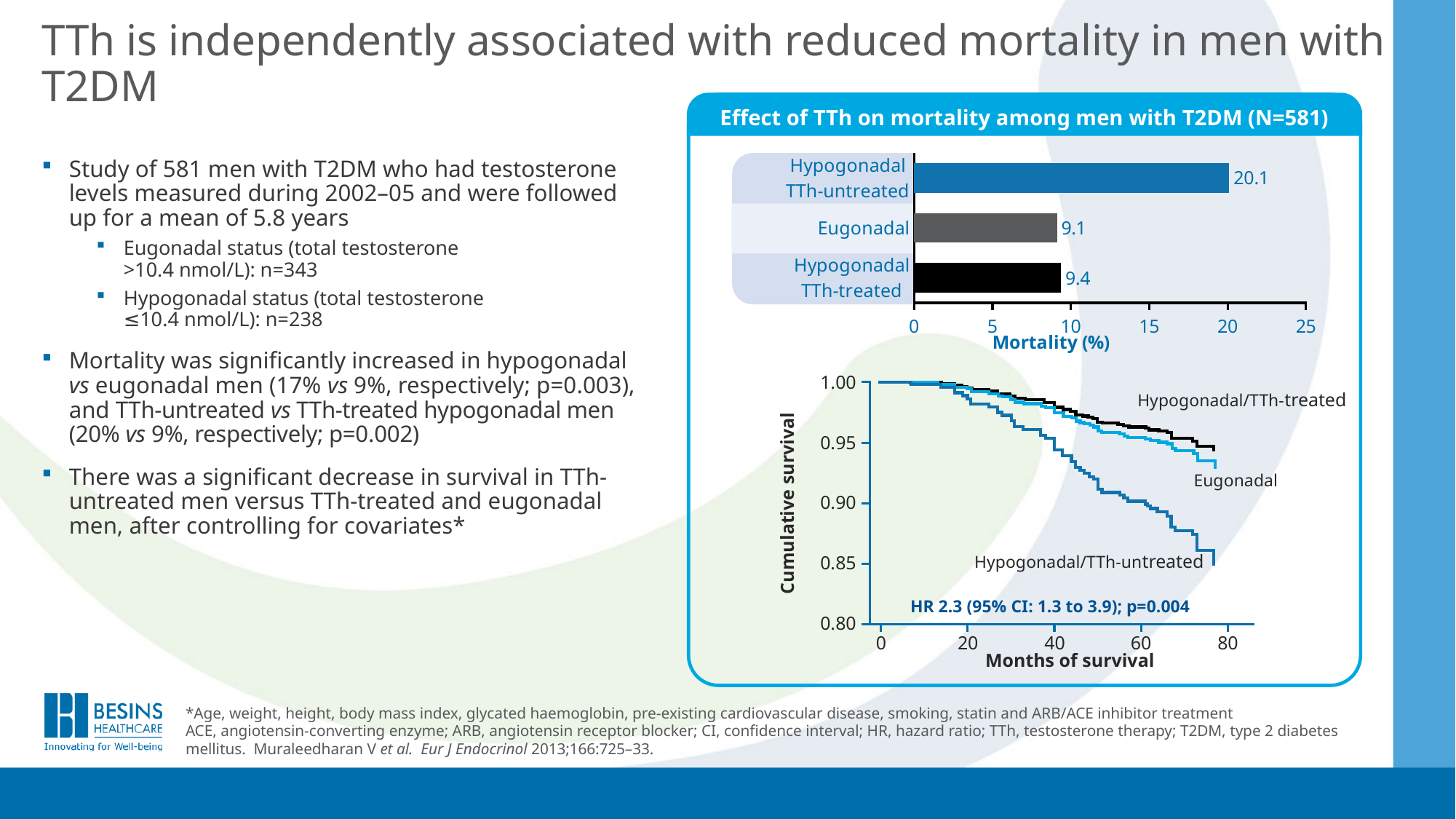
In the bar chart, which group has the lowest mortality? Eugonadal In the survival chart, does cumulative survival rise or fall as months of survival increase? Fall In the bar chart, what is the difference in mortality (%) between Hypogonadal TTh-untreated and Hypogonadal TTh-treated men? 10.7 In the bar chart, is the mortality for Hypogonadal TTh-untreated men greater or less than 15%? greater In the bar chart, which group has the highest mortality? Hypogonadal TTh-untreated What type of chart is the upper chart showing mortality (%)? Bar chart In the bar chart, what is the mortality (%) for Eugonadal men? 9.1 In the survival chart, how many groups (curves) are plotted? 3 In the bar chart, how many groups are shown? 3 In the bar chart, what is the mortality (%) for Hypogonadal TTh-untreated men? 20.1 In the bar chart, what is the mortality (%) for Hypogonadal TTh-treated men? 9.4 In the survival chart, is the cumulative survival of the Hypogonadal/TTh-untreated group at the end of follow-up greater or less than 0.90? less